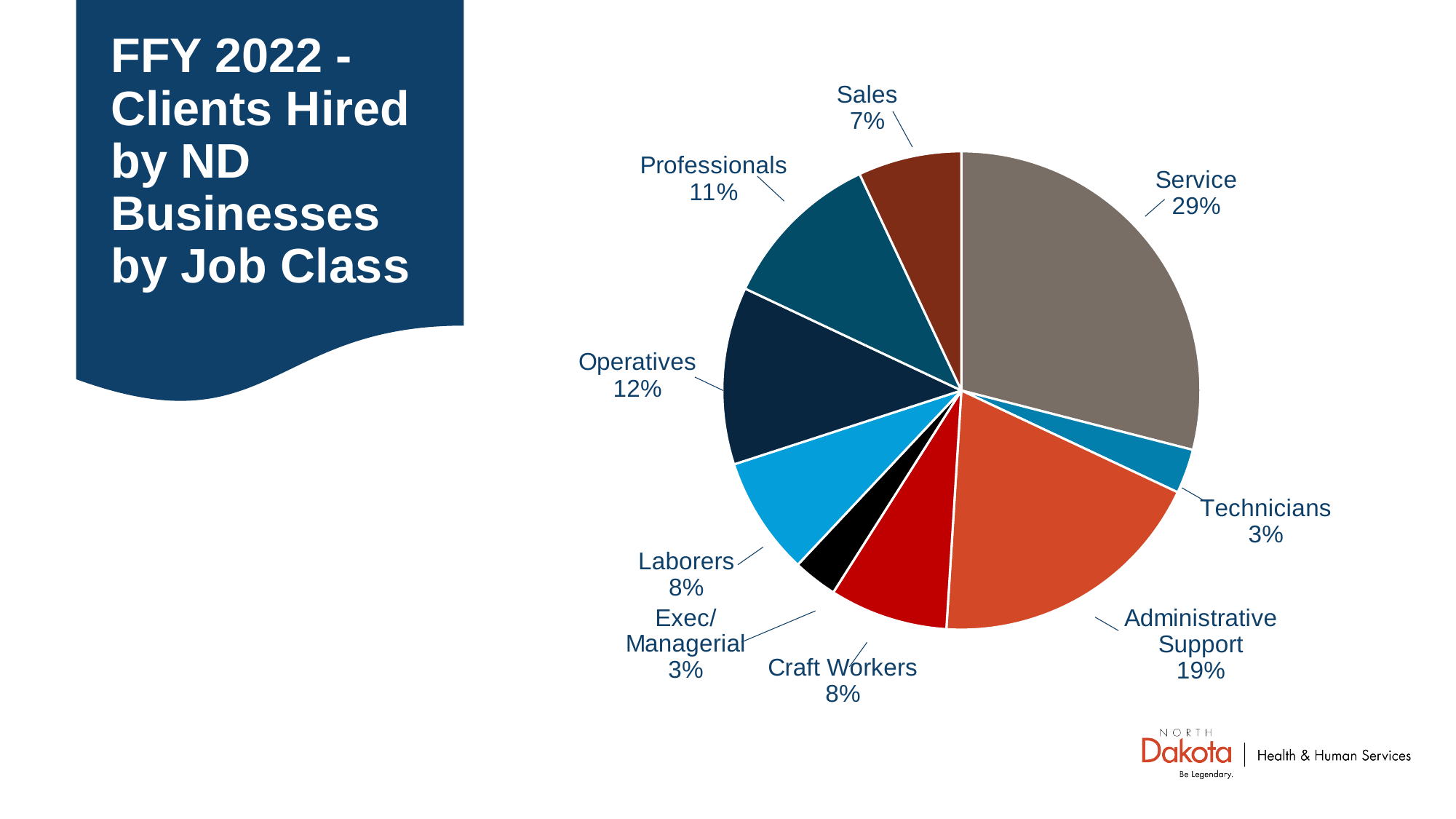
Which is larger, the share for Professionals or the share for Sales? Professionals What kind of chart is shown on the slide? Pie chart What percentage is shown for Technicians? 3% What is the combined share of Laborers and Craft Workers? 16% How many job class slices does the pie chart have? 9 What percentage is shown for Operatives? 12% Which job classes are tied for the smallest share? Technicians and Exec/Managerial What share of clients hired were in the Service job class? 29% What is the difference in percentage points between Service and Administrative Support? 10 Which job class has the largest share of clients hired? Service What is the title of the slide containing the pie chart? FFY 2022 - Clients Hired by ND Businesses by Job Class What percentage is shown for Administrative Support? 19%